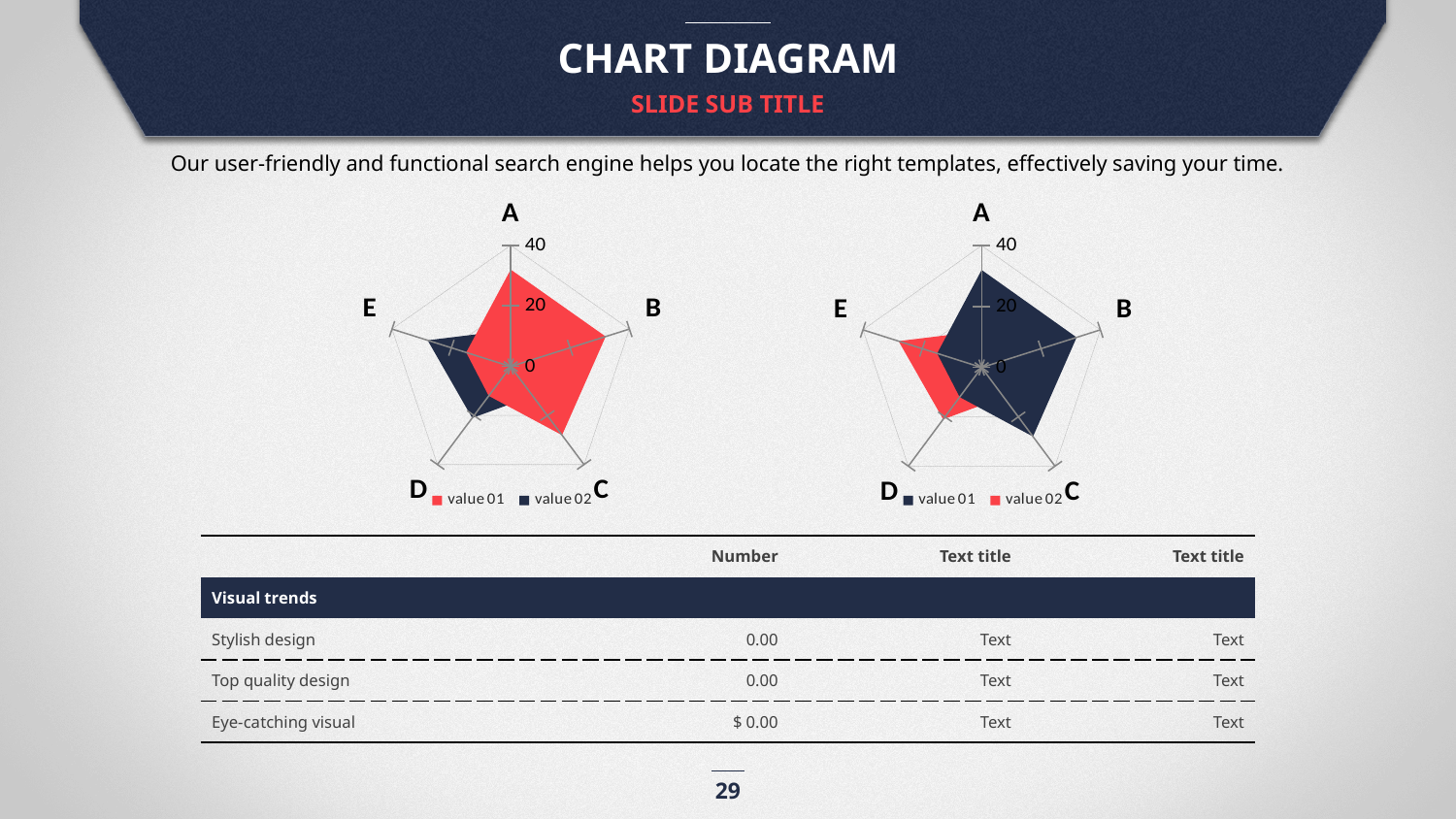
How many categories (axes) does the left chart have? 5 In the right chart, is the value 01 series at B greater or less than 20? greater In the right chart, is the value 01 series at E greater or less than 20? less In the left chart, is the value 01 series at B greater or less than 20? greater What kind of chart is the left chart? radar chart What are the legend entries of the left chart? value 01, value 02 What colour represents value 01 in the right chart? dark navy How many series does the legend of the right chart list? 2